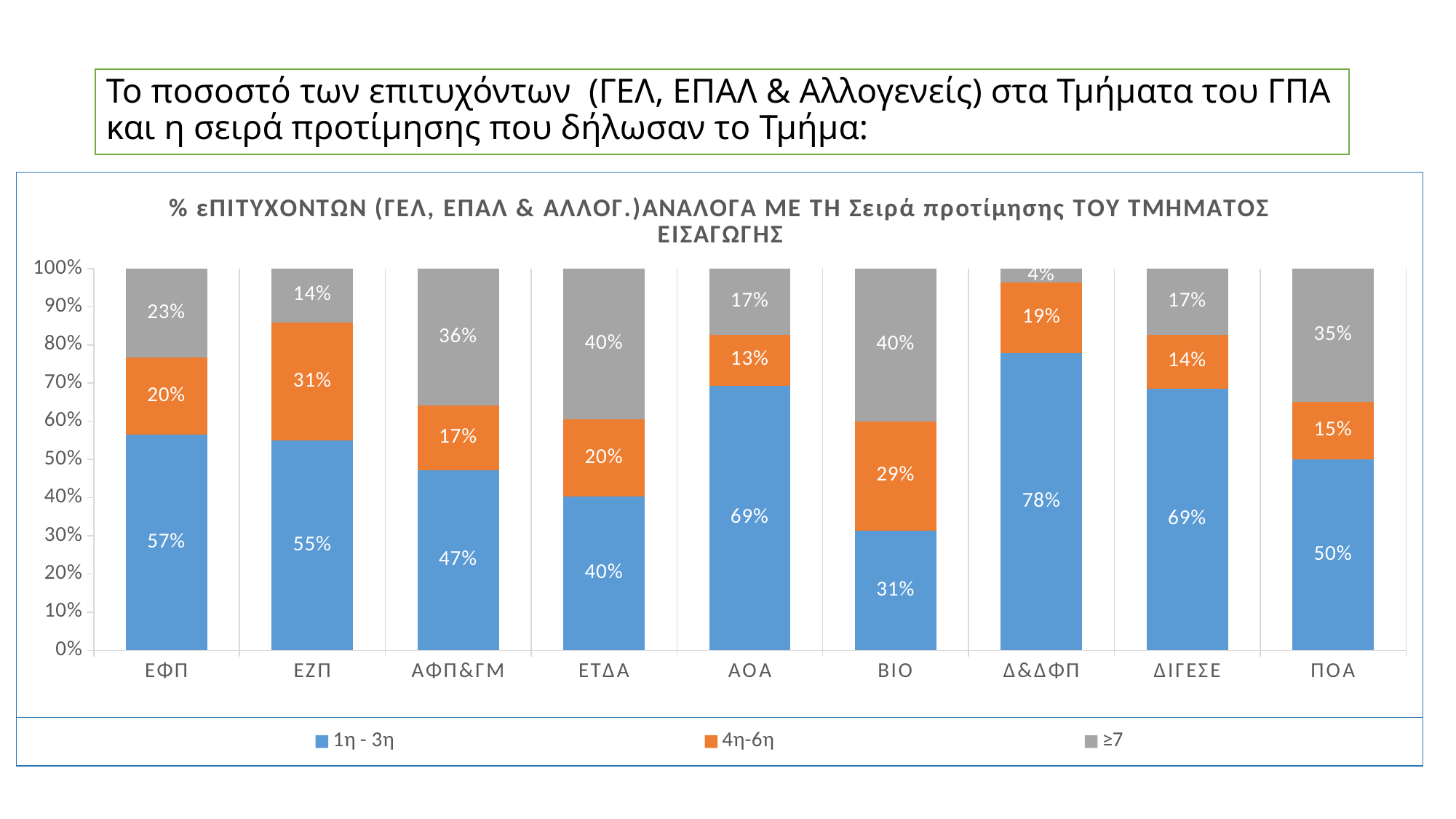
How many departments are shown on the x axis? 9 Which department has the highest 4η-6η percentage? ΕΖΠ Which department has the highest 1η - 3η percentage? Δ&ΔΦΠ What is the 4η-6η value for ΒΙΟ? 29% What percentage of successful candidates at ΕΦΠ declared the department as their 1η - 3η preference? 57% What is the difference between the 1η - 3η values for Δ&ΔΦΠ and ΕΤΔΑ? 38% What kind of chart is shown on the slide? Stacked bar chart Which department has the lowest 1η - 3η percentage? ΒΙΟ What is the ≥7 value for ΑΦΠ&ΓΜ? 36% How many series does the legend list? 3 Which department has the lowest ≥7 percentage? Δ&ΔΦΠ Which is larger: the ≥7 value for ΠΟΑ or the ≥7 value for ΕΖΠ? ΠΟΑ